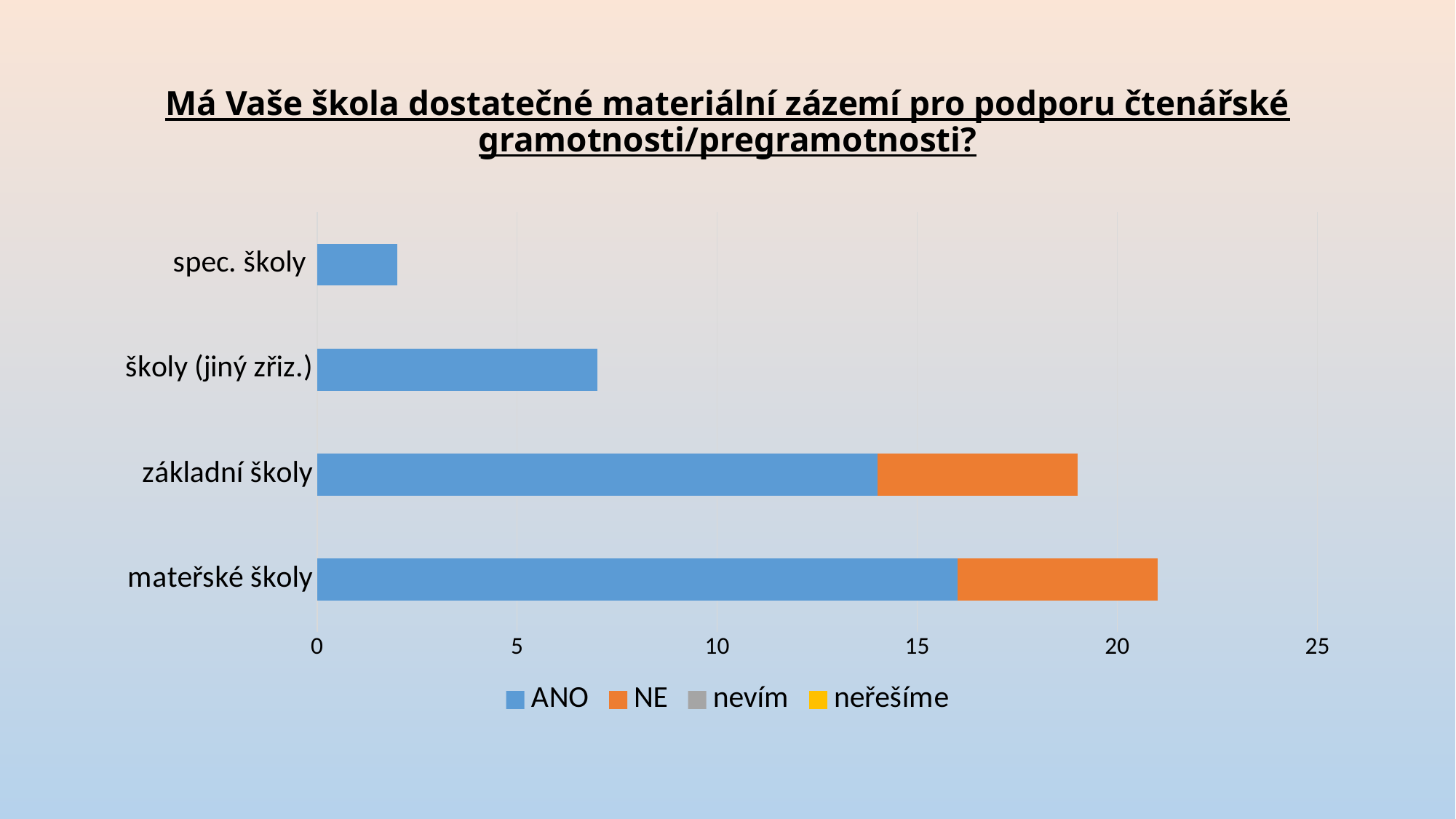
Which category has the shortest total bar? spec. školy What kind of chart is shown on the slide? bar chart Is the ANO value for spec. školy greater or less than 5? less Is the ANO value for školy (jiný zřiz.) greater or less than 5? greater Is the ANO value for mateřské školy greater or less than 15? greater How many series does the legend list? 4 Which has a larger ANO value, základní školy or školy (jiný zřiz.)? základní školy Which colour represents the NE series in the legend? orange Which category has the longest total bar? mateřské školy How many categories are shown on the vertical axis of the chart? 4